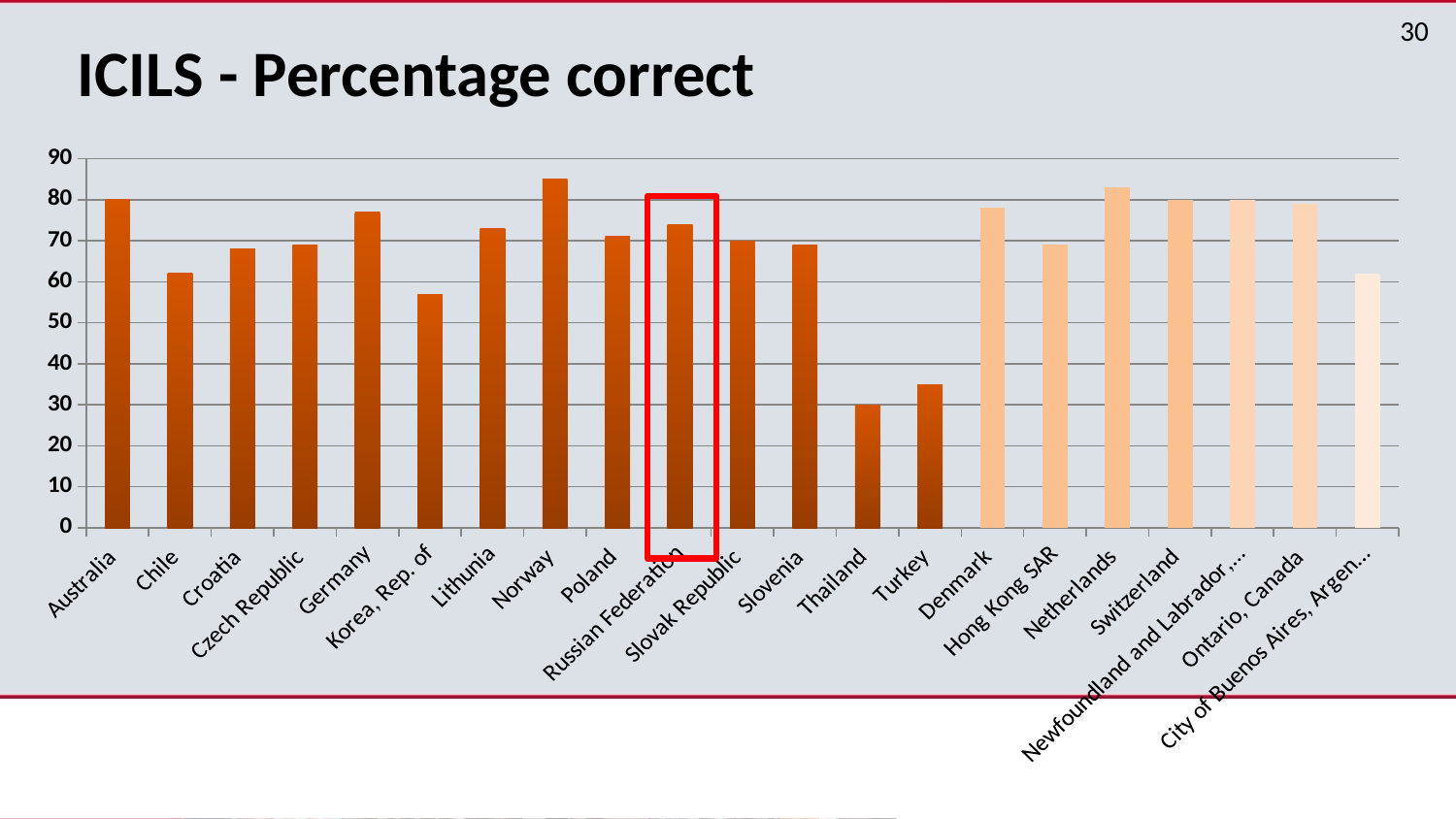
Is the value for Korea, Rep. of greater or less than 60? less What is the value for Thailand? 30 Is the value for Germany greater or less than 70? greater How many countries or regions are shown on the x axis? 21 Which country's bar is highlighted with a red box? Russian Federation Which country has the lowest percentage correct? Thailand What is the value for Slovak Republic? 70 What is the value for Australia? 80 Is the value for Turkey greater or less than 40? less What type of chart is shown on the slide? bar chart What is the title of the chart? ICILS - Percentage correct Which has a higher value, Norway or Poland? Norway